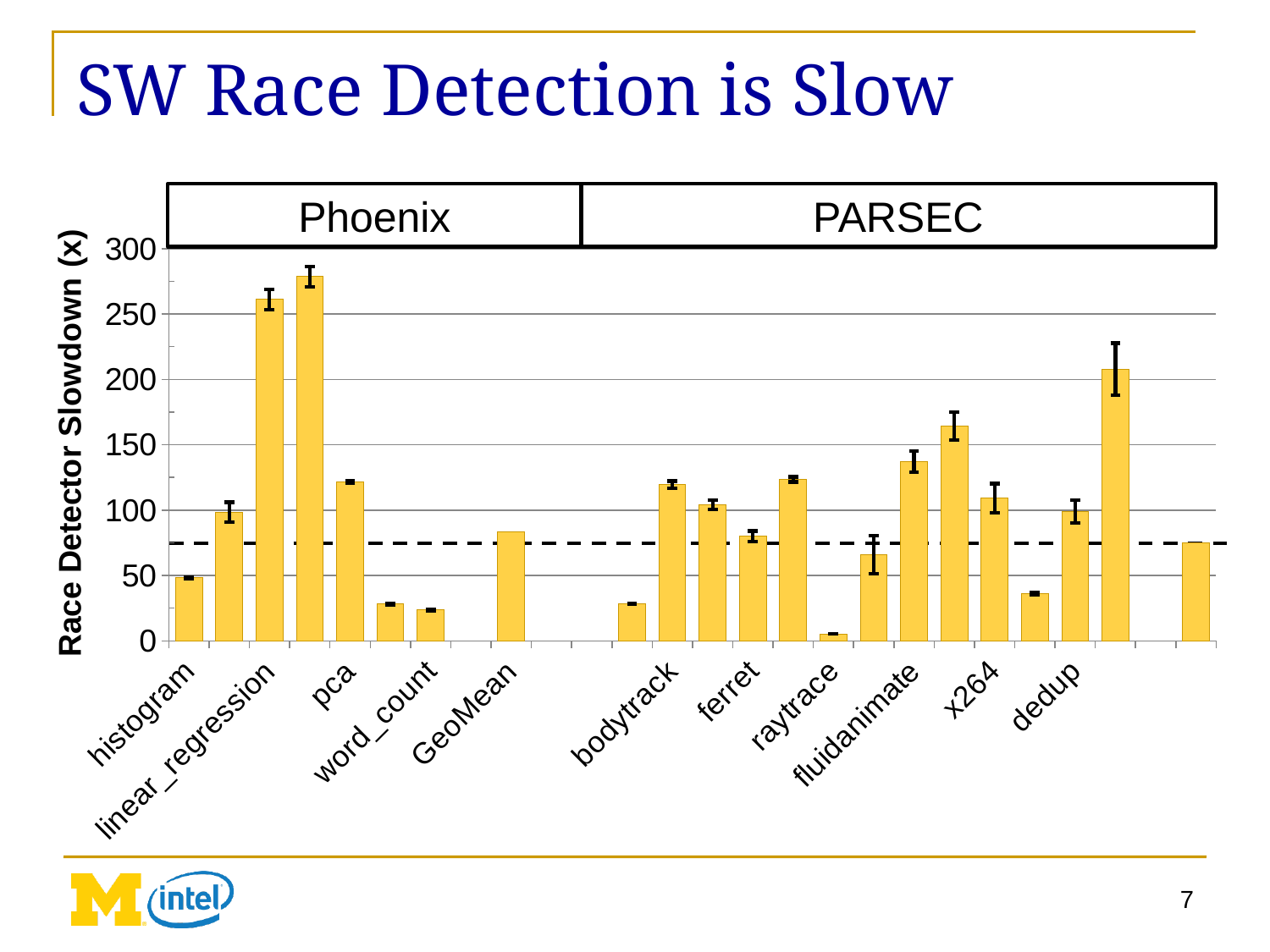
What kind of chart is shown on the slide? bar chart Is the value for word_count greater or less than 50? less Is the value for pca greater or less than 100? greater Is the value for GeoMean in the Phoenix group greater or less than 100? less Which has the larger value, linear_regression or pca? linear_regression What is the title of the slide containing the chart? SW Race Detection is Slow What is the label on the y axis of the chart? Race Detector Slowdown (x) Which of the labelled benchmarks has the lowest race detector slowdown? raytrace